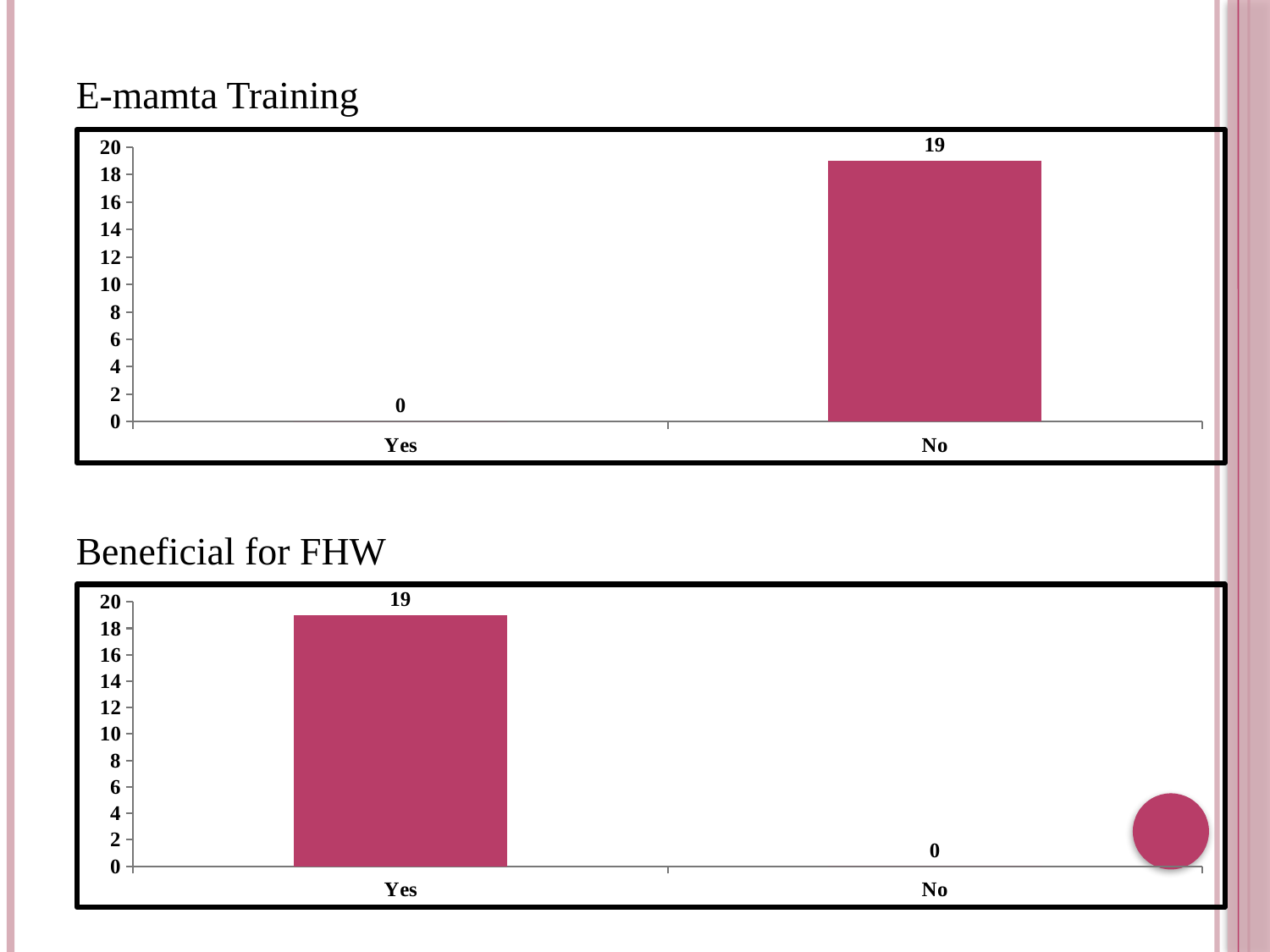
In the E-mamta Training chart, what is the value for Yes? 0 What kind of chart is the E-mamta Training chart? bar chart In the E-mamta Training chart, what is the value for No? 19 In the Beneficial for FHW chart, what is the value for No? 0 In the E-mamta Training chart, what is the difference between the values for No and Yes? 19 How many categories are shown in the Beneficial for FHW chart? 2 In the Beneficial for FHW chart, which is larger, the value for Yes or the value for No? Yes In the E-mamta Training chart, is the value for No greater or less than 10? greater What is the title of the lower chart on the slide? Beneficial for FHW In the E-mamta Training chart, which category has the highest value? No In the Beneficial for FHW chart, what is the value for Yes? 19 In the Beneficial for FHW chart, which category has the lowest value? No